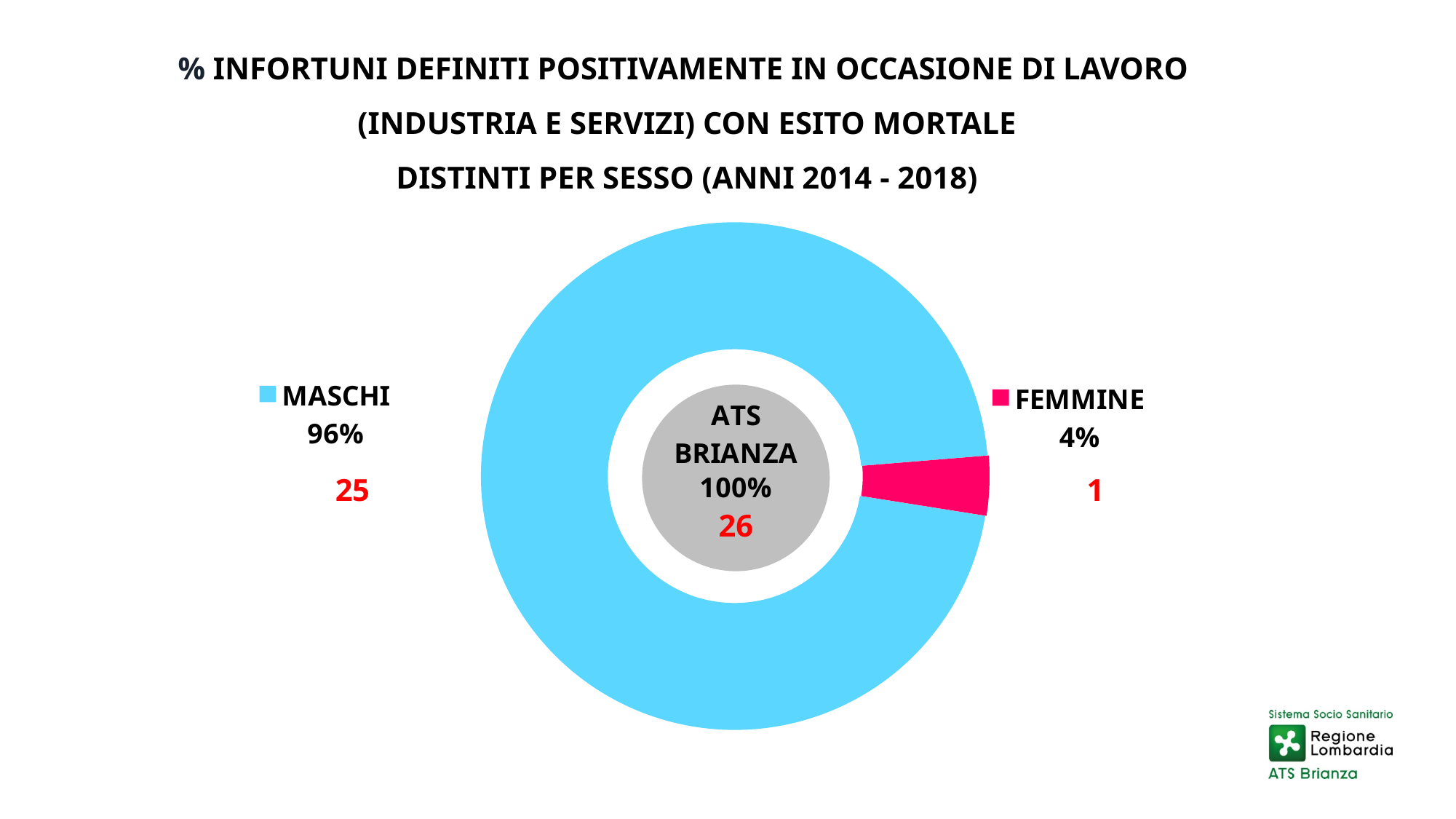
What percentage share does FEMMINE have in the chart? 4% What is the difference between the counts for MASCHI and FEMMINE? 24 Which is larger, the share for MASCHI or the share for FEMMINE? MASCHI What is the count shown for MASCHI? 25 What kind of chart is shown on the slide? Doughnut (pie) chart Which category has the smallest share of the chart? FEMMINE Which category has the largest share of the chart? MASCHI How many categories does the chart show? 2 What percentage share does MASCHI have in the chart? 96% What colour is used for the FEMMINE slice? Pink/magenta What is the count shown for FEMMINE? 1 What total number is shown in the centre of the chart for ATS BRIANZA? 26